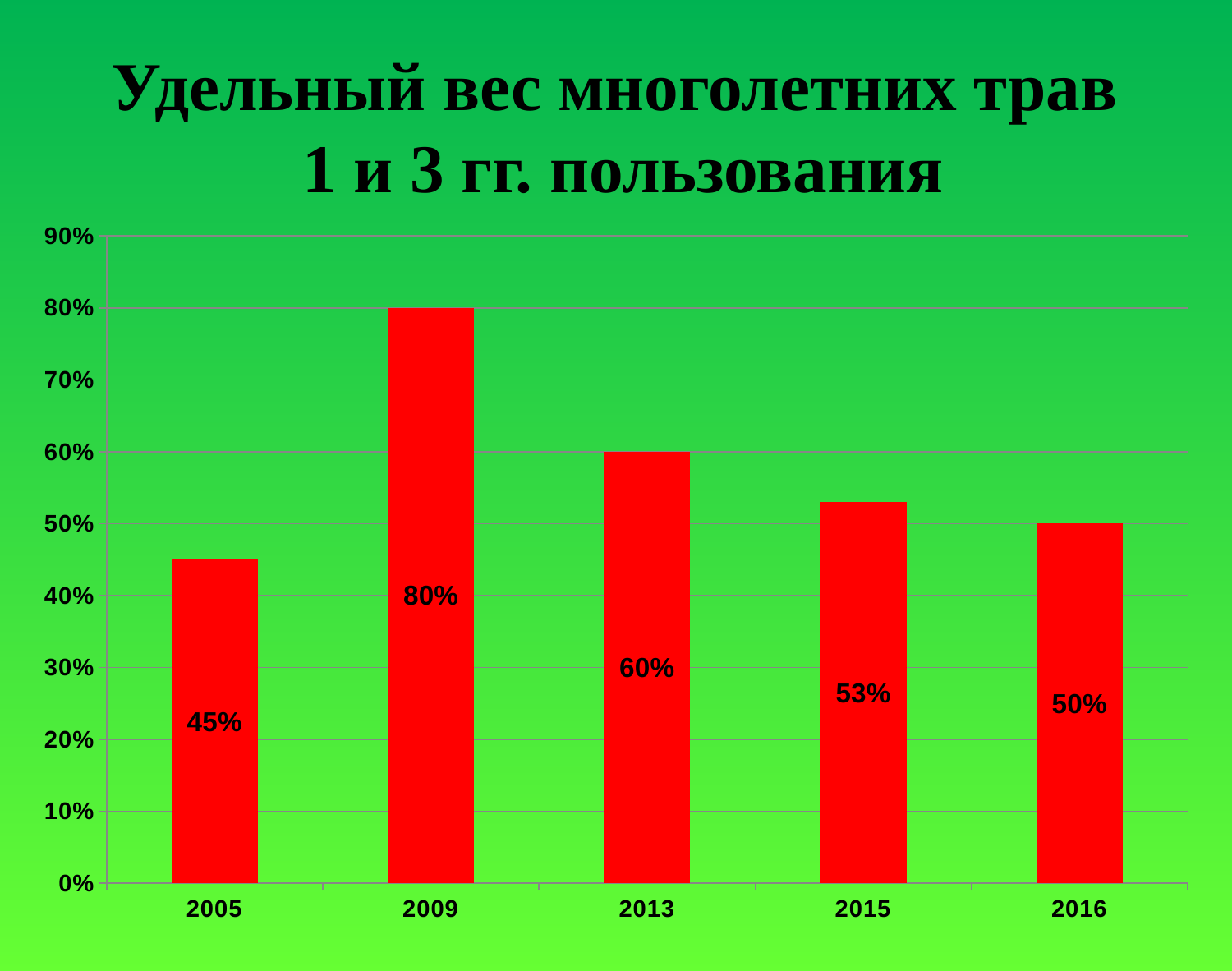
What is the value for 2009? 80% What is the value for 2013? 60% What kind of chart is shown on the slide? bar chart What is the value for 2016? 50% How many years are shown on the x axis? 5 What is the value for 2015? 53% Which year has the highest value? 2009 Which year has the lowest value? 2005 What is the value for 2005? 45% Which is larger, the value for 2015 or the value for 2016? 2015 Is the value for 2005 greater or less than 50%? less What is the difference between the values for 2009 and 2013? 20%